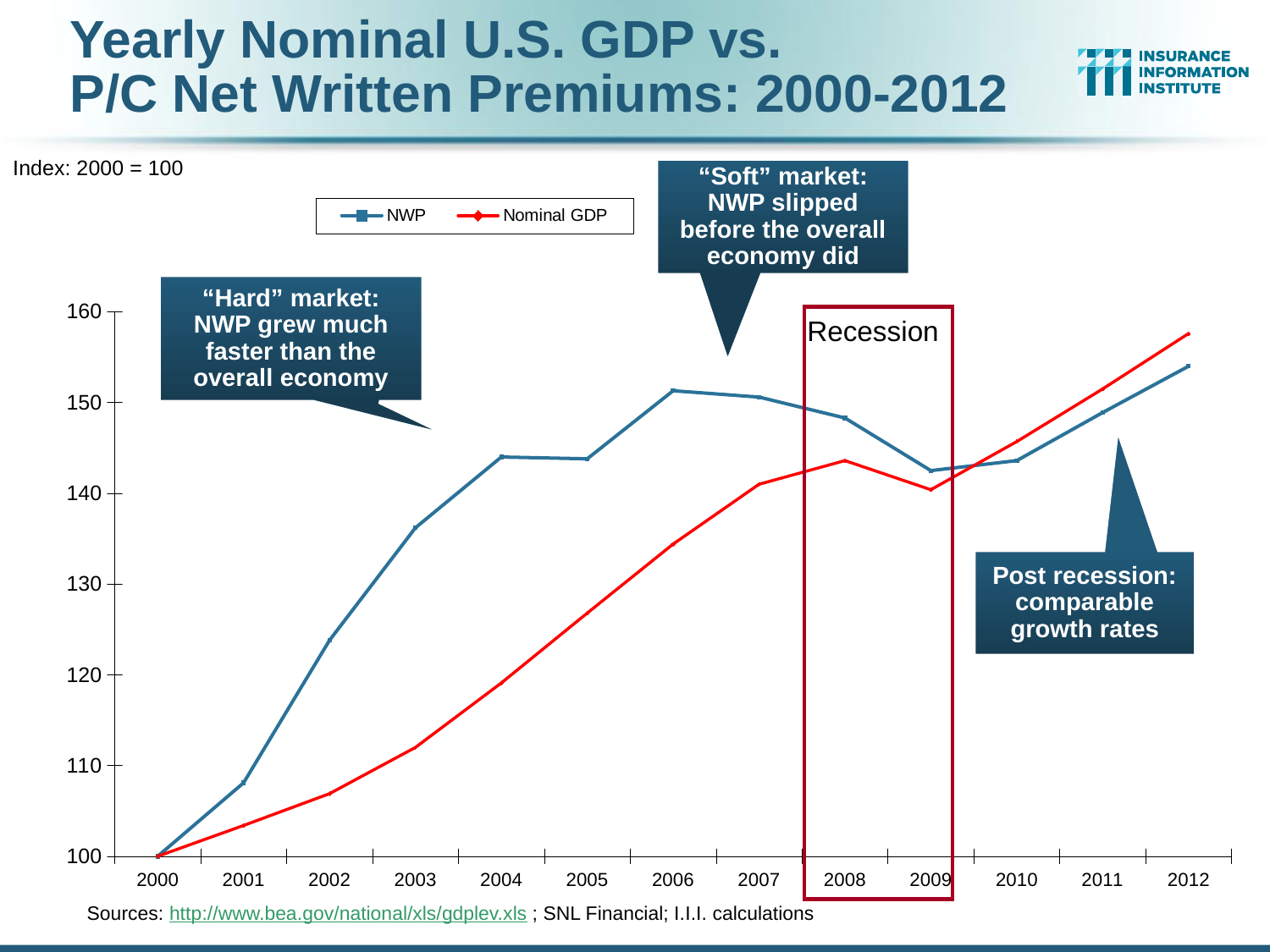
Is the Nominal GDP value for 2005 greater or less than 130? less What kind of chart is shown on the slide? Line chart Is the NWP value for 2002 greater or less than 120? greater Which years does the box labelled "Recession" cover? 2008 and 2009 What is the NWP index value in 2000? 100 In which year is the Nominal GDP index at its lowest? 2000 In 2012, which series has the higher value, NWP or Nominal GDP? Nominal GDP How many years are shown on the x axis? 13 In 2006, which series has the higher value, NWP or Nominal GDP? NWP Is the NWP value for 2009 greater or less than 140? greater How many series does the legend list? 2 Does the Nominal GDP line rise or fall from 2000 to 2008? Rise